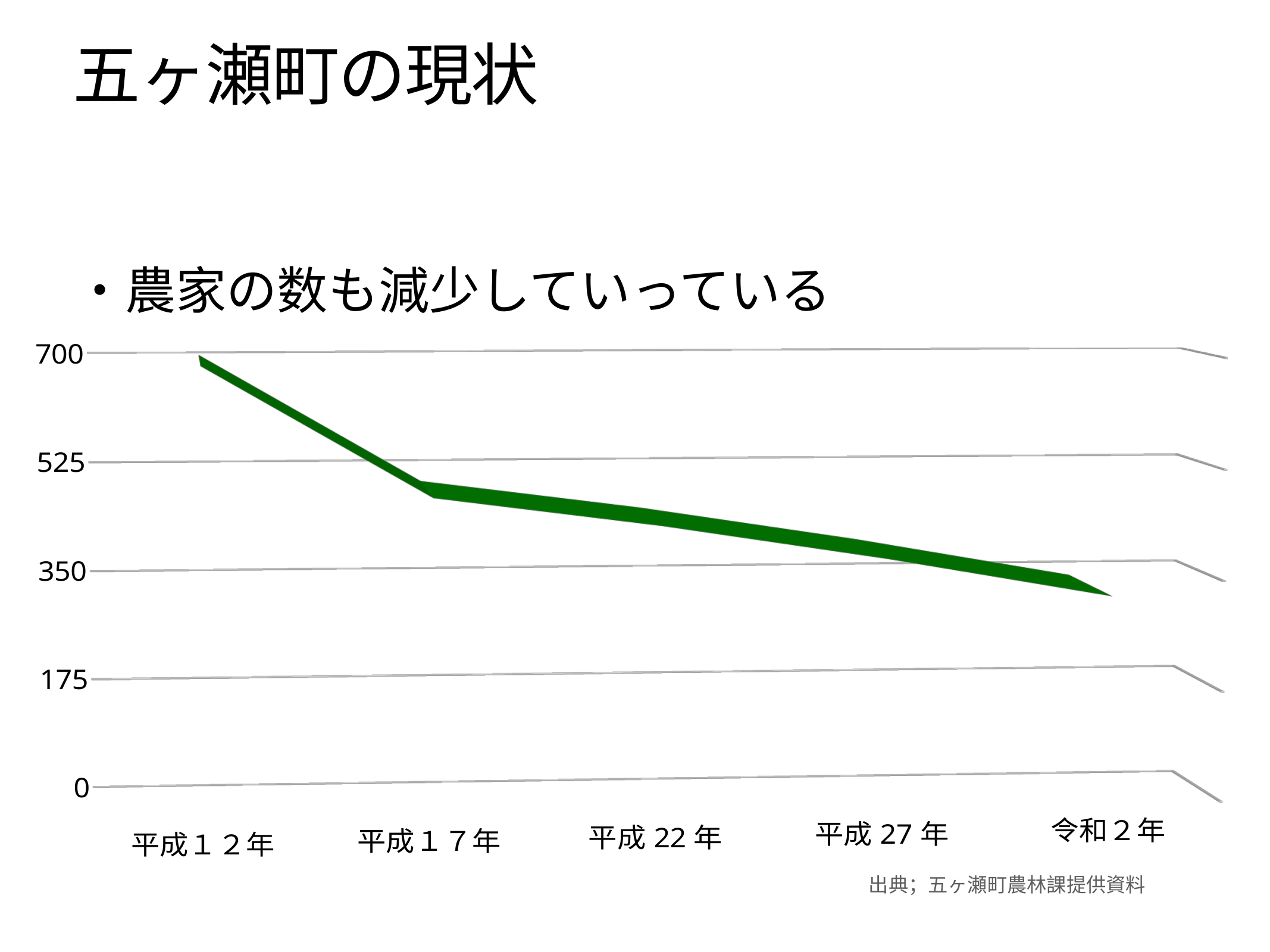
Which is larger, the value for 平成１７年 or the value for 令和２年? 平成１７年 Which year has the lowest value on the chart? 令和２年 Is the value for 令和２年 greater or less than 350? less What colour is the line plotted on the chart? green What kind of chart is shown on the slide? line chart Which year has the highest value on the chart? 平成１２年 Is the value for 平成 22 年 greater or less than 350? greater Do the values rise or fall from 平成１２年 to 令和２年? fall Is the value for 平成１２年 greater or less than 525? greater Which is larger, the value for 平成１２年 or the value for 平成１７年? 平成１２年 How many points (years) are plotted on the x axis of the chart? 5